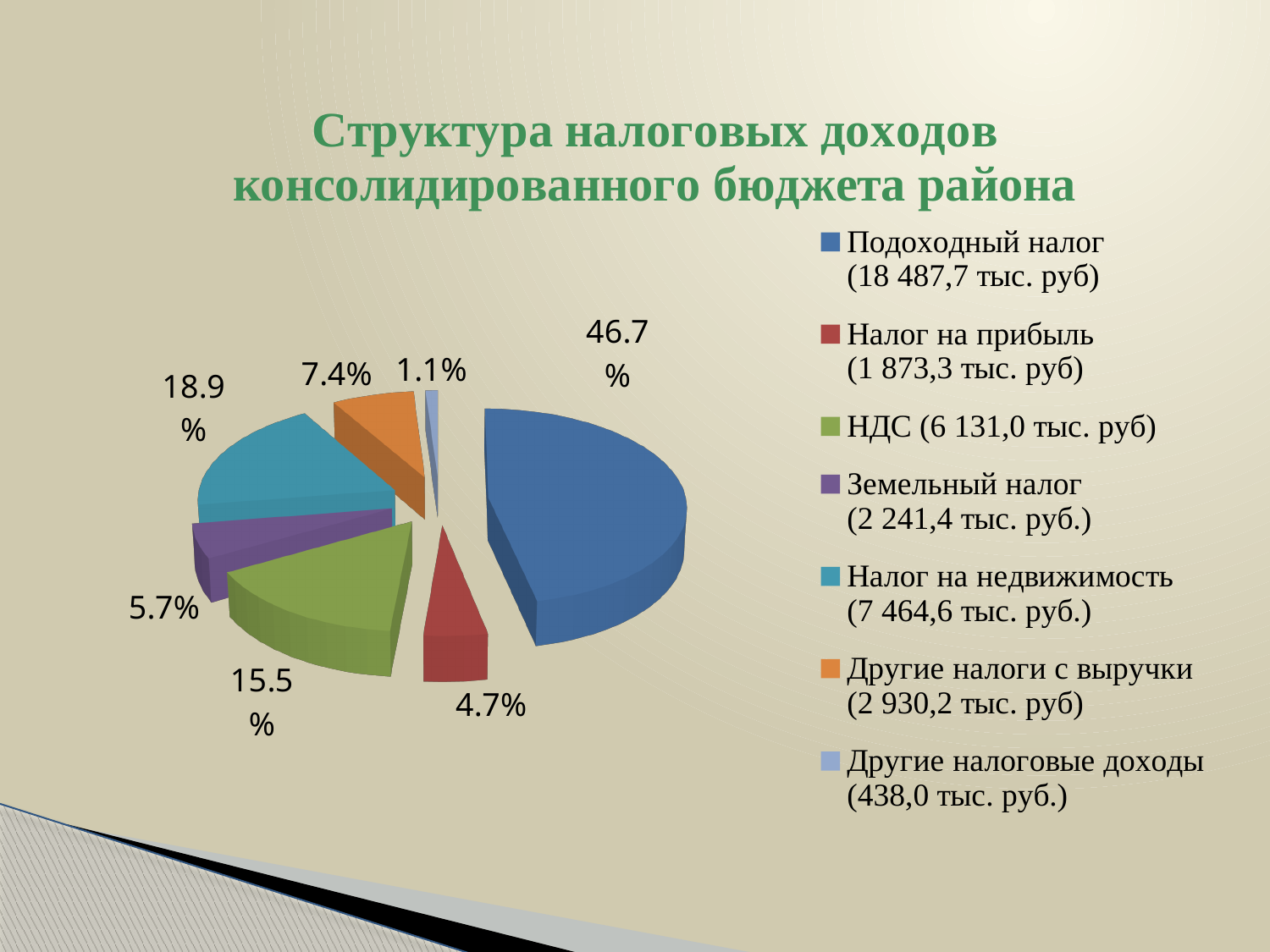
What share of the pie does НДС have? 15.5% What is the difference in percentage points between the shares of Налог на недвижимость and НДС? 3.4 What share of the pie does Земельный налог have? 5.7% What is the title of the slide? Структура налоговых доходов консолидированного бюджета района Which has a larger share: Другие налоги с выручки or Налог на прибыль? Другие налоги с выручки How many slices does the pie chart have? 7 What share of the pie does Подоходный налог have? 46.7% Which category has the largest slice of the pie? Подоходный налог Which category has the smallest slice of the pie? Другие налоговые доходы According to the legend, what amount in thousand rubles is given for НДС? 6 131,0 тыс. руб What kind of chart is shown on the slide? pie chart